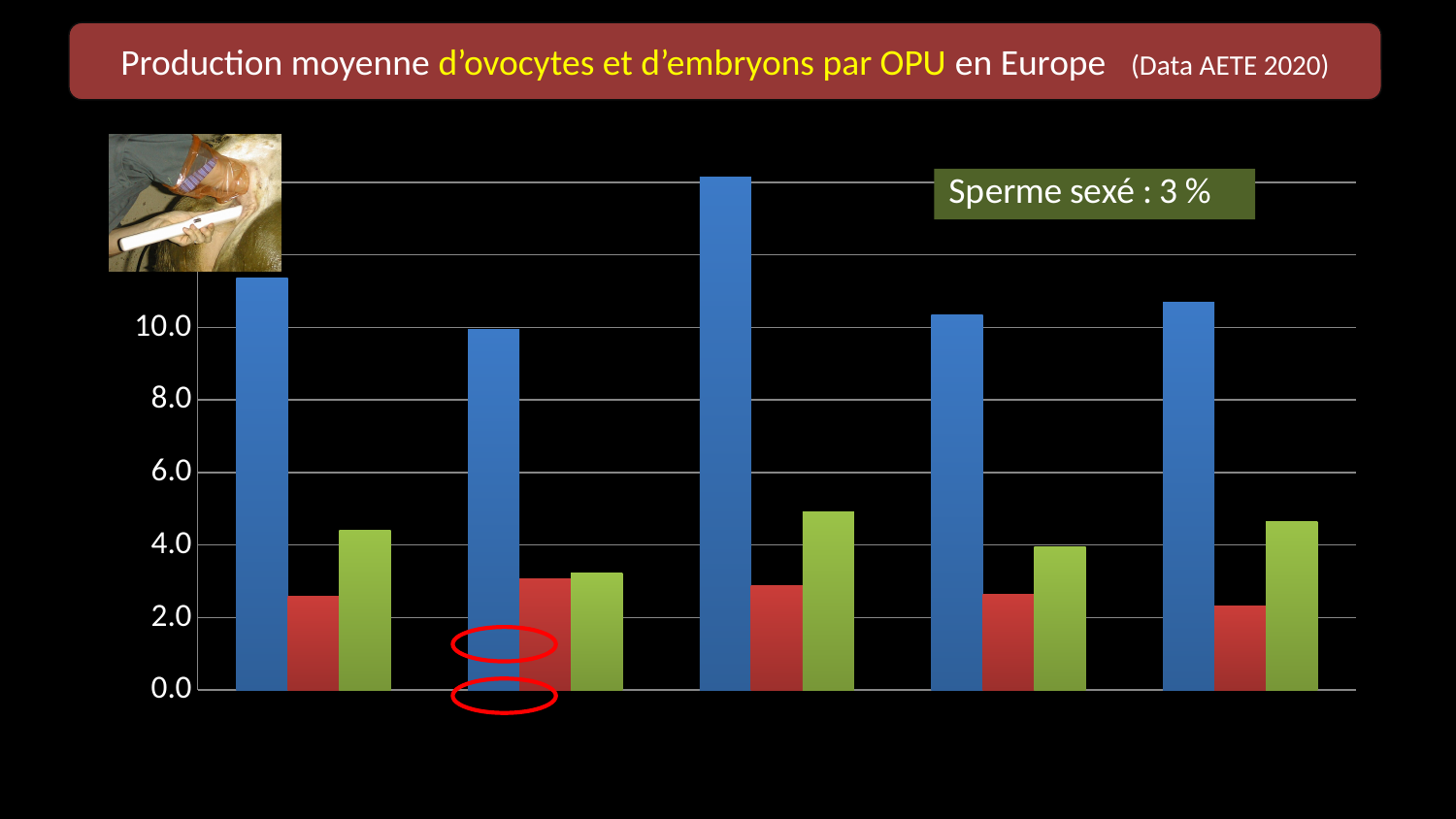
Is the red bar in the second group from the left greater or less than 2.0? greater What is the title of the slide containing the chart? Production moyenne d'ovocytes et d'embryons par OPU en Europe (Data AETE 2020) Is the green bar in the third group from the left greater or less than 4.0? greater What percentage is given in the green text box on the chart for 'Sperme sexé'? 3 % Is the green bar in the second group from the left greater or less than 4.0? less How many bars are there in each group? 3 What kind of chart is shown on the slide? bar chart Which group of bars, counting from the left, has the tallest blue bar? the third group How many groups of bars are plotted along the x axis? 5 Which is taller: the blue bar in the first group or the blue bar in the fourth group? the blue bar in the first group Which group of bars, counting from the left, has the shortest blue bar? the second group